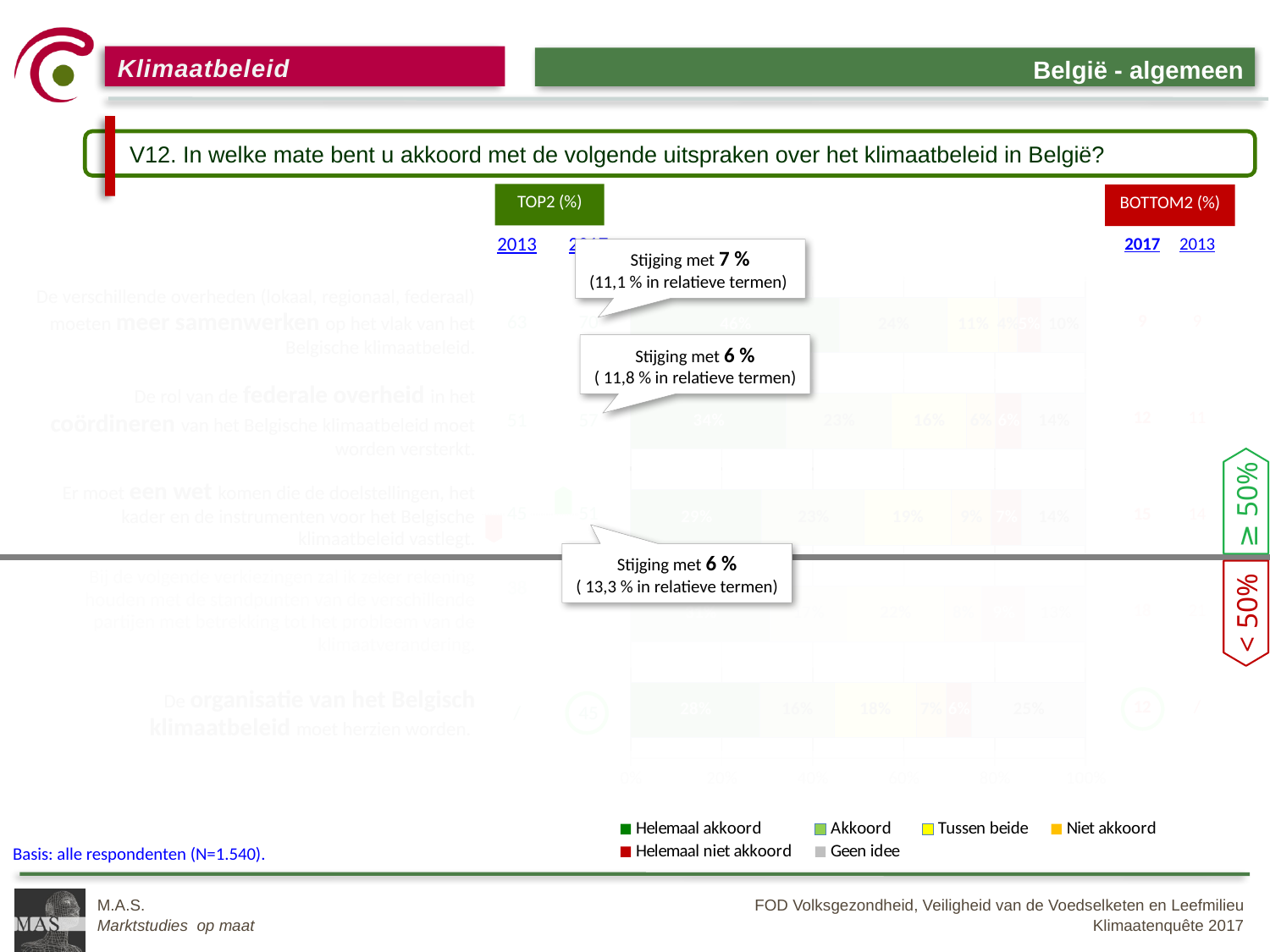
What is the last entry in the chart's legend? Geen idee According to the top callout on the chart, by how many percentage points did the value rise? 7 % Which two years are compared in the TOP2 (%) columns next to the chart? 2013 and 2017 According to the bottom callout on the chart, what is the rise in relative terms? 13,3 % How many statements (categories) are plotted in the chart? 5 According to the top callout on the chart, what is the rise in relative terms? 11,1 % What kind of chart is shown on the slide? bar chart According to the middle callout on the chart, what is the rise in relative terms? 11,8 % What is the first entry in the chart's legend? Helemaal akkoord How many series does the chart's legend list? 6